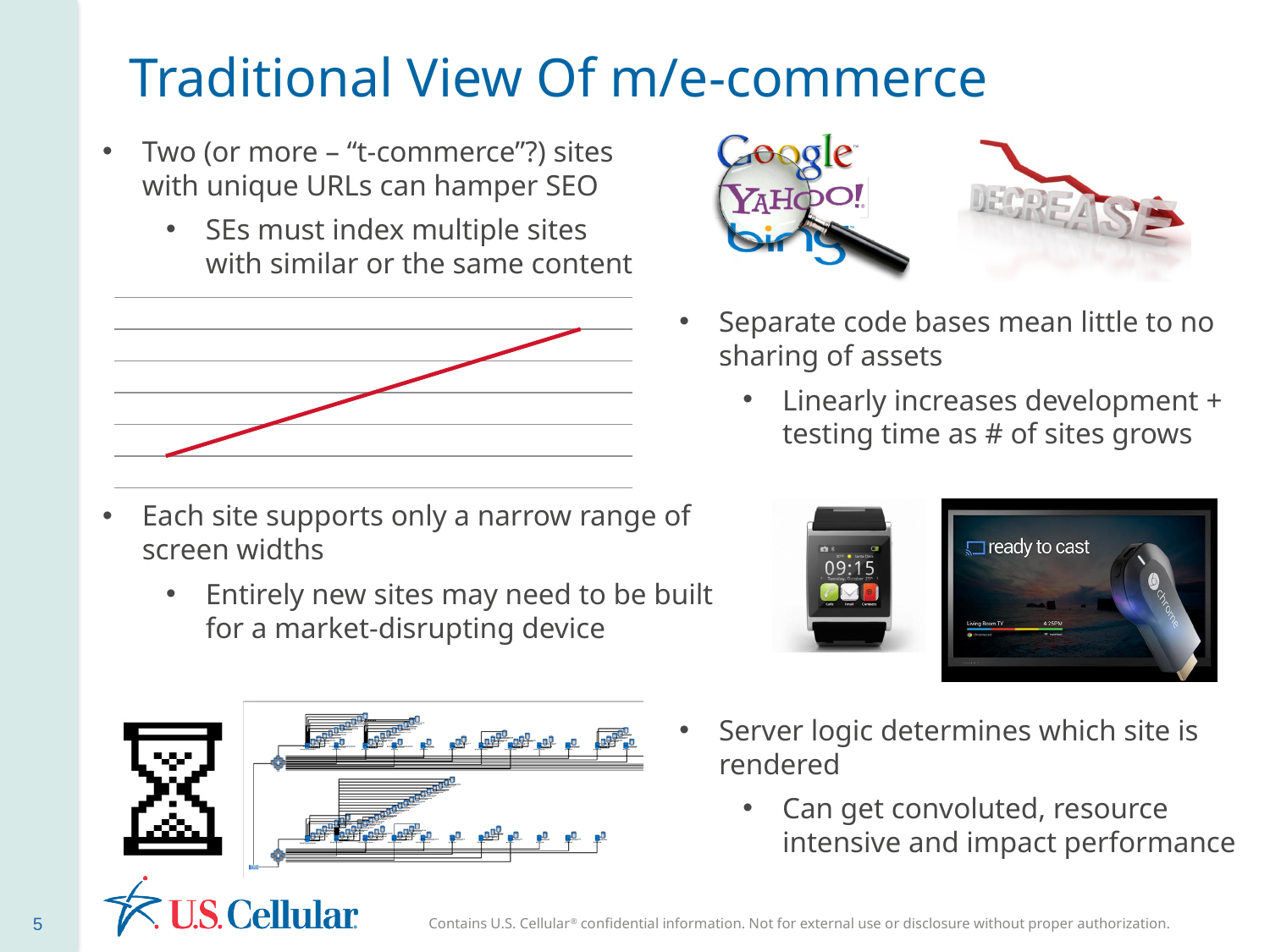
What kind of chart is shown on the left side of the slide, below the SEO bullet points? line chart What colour is the line plotted in the line chart on the left side of the slide? red In the line chart on the left side of the slide, does the plotted line rise or fall from left to right? rise How many lines are plotted in the line chart on the left side of the slide? 1